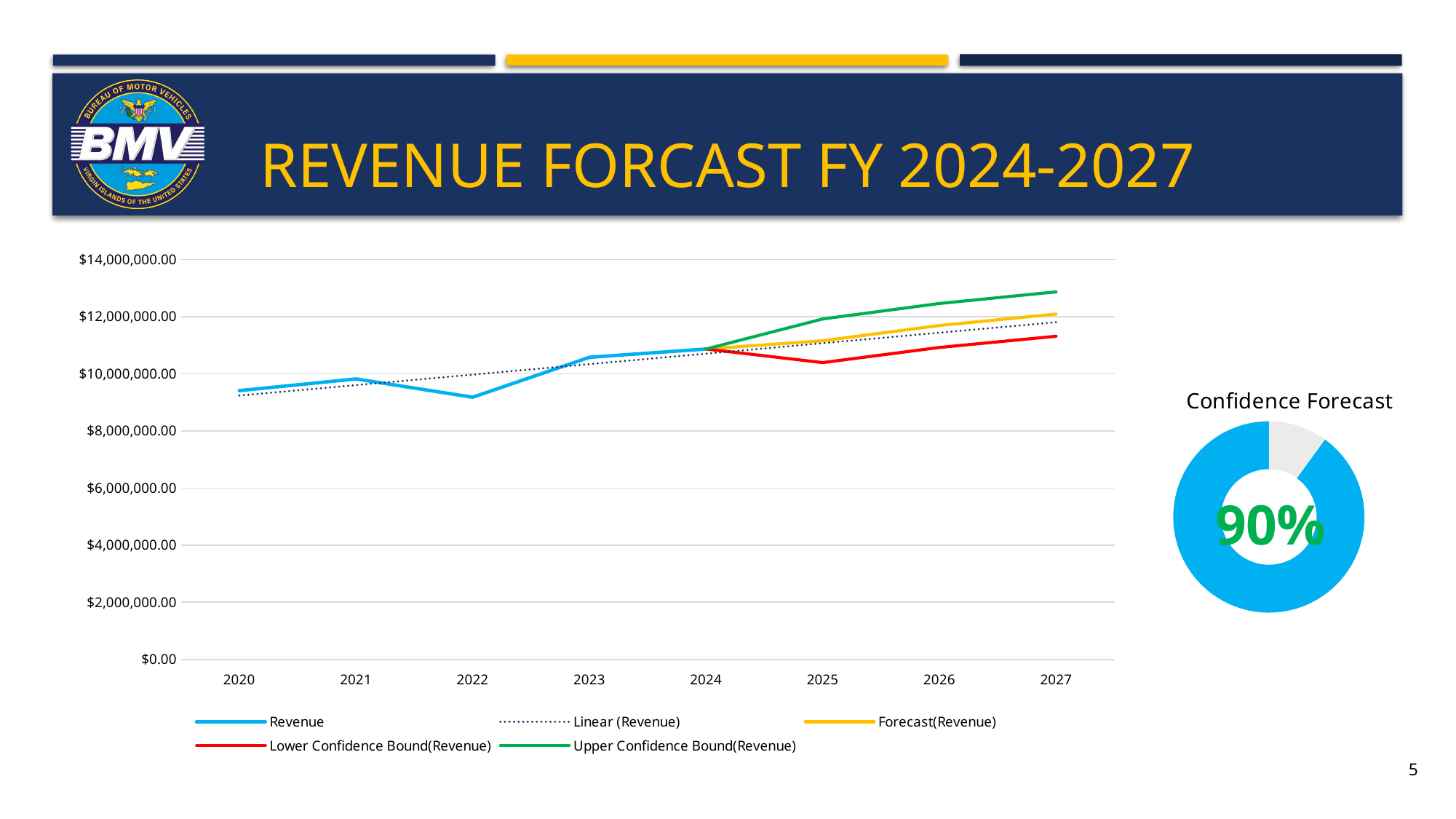
In the line chart, how many years are shown on the x axis? 8 In the line chart, which is larger in 2027: the Upper Confidence Bound(Revenue) or the Lower Confidence Bound(Revenue)? Upper Confidence Bound(Revenue) What kind of chart is the large chart on the left of the slide? line chart In the line chart, is the Revenue value for 2023 greater or less than $10,000,000.00? greater In the line chart, is the Upper Confidence Bound(Revenue) value for 2027 greater or less than $12,000,000.00? greater In the line chart, is the Revenue value for 2022 greater or less than $10,000,000.00? less In the line chart, does the Upper Confidence Bound(Revenue) line rise or fall from 2024 to 2027? rise In the line chart, does the Revenue line rise or fall from 2021 to 2022? fall In the line chart, which series is drawn as a dotted line according to the legend? Linear (Revenue) In the line chart, how many series does the legend list? 5 What percentage is shown in the centre of the Confidence Forecast donut chart? 90%